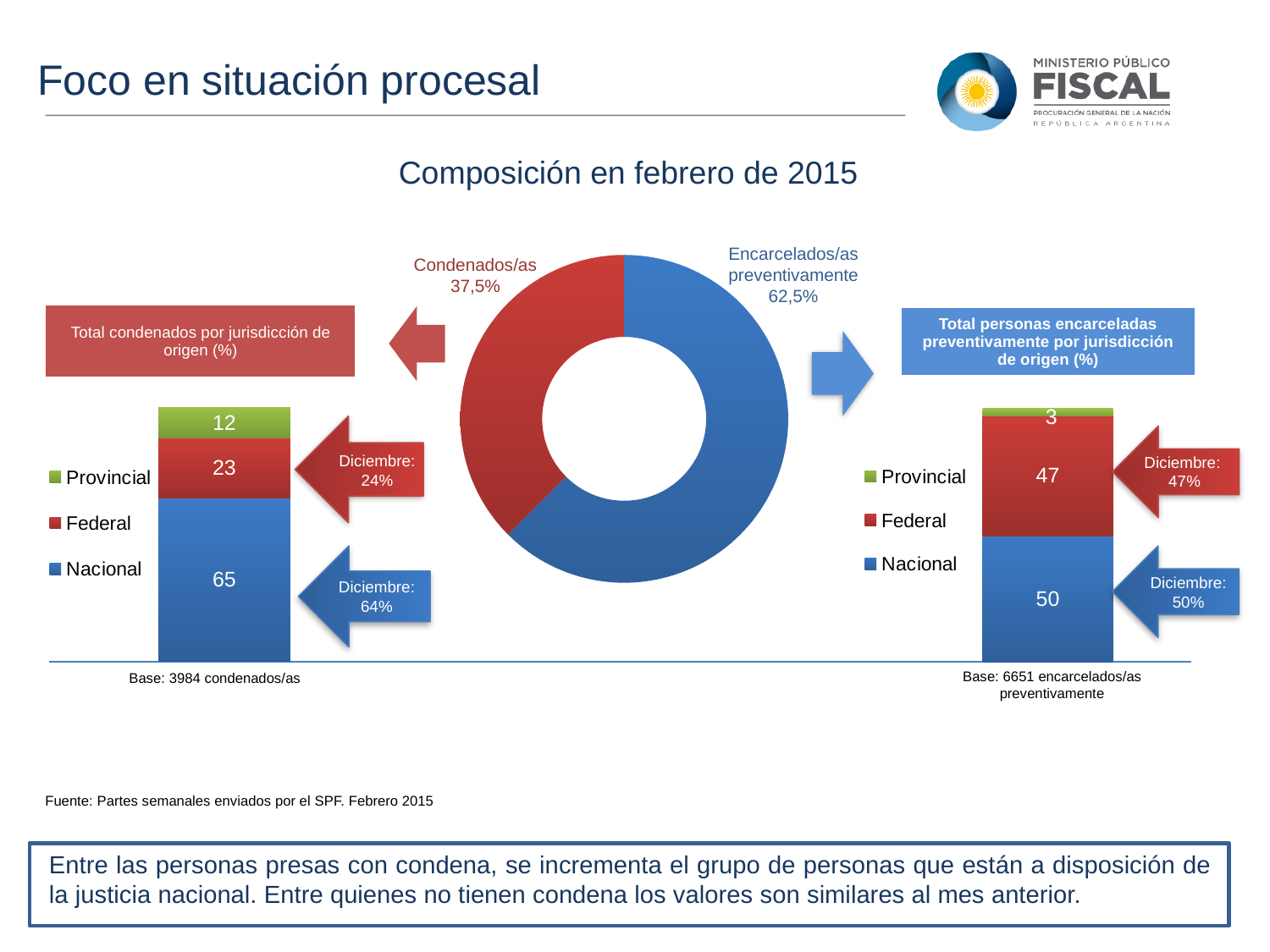
How many series does the legend of the left stacked bar chart (Total condenados por jurisdicción de origen) list? 3 In the left stacked bar chart (Total condenados por jurisdicción de origen), what is the value for Nacional? 65 In the right stacked bar chart (Total personas encarceladas preventivamente por jurisdicción de origen), what is the value for Federal? 47 In the right stacked bar chart (Total personas encarceladas preventivamente por jurisdicción de origen), which jurisdiction has the highest value? Nacional In the central donut chart, what share is labelled for Condenados/as? 37,5% In the left stacked bar chart (Total condenados por jurisdicción de origen), which jurisdiction has the lowest value? Provincial What kind of chart is the central chart showing Condenados/as and Encarcelados/as preventivamente? Donut (pie) chart In the left stacked bar chart (Total condenados por jurisdicción de origen), what is the value for Provincial? 12 Is the Federal value larger in the left stacked bar chart (Total condenados) or in the right stacked bar chart (Total personas encarceladas preventivamente)? Right chart (Total personas encarceladas preventivamente) In the central donut chart, what share is labelled for Encarcelados/as preventivamente? 62,5% In the left stacked bar chart (Total condenados por jurisdicción de origen), what is the difference between Nacional and Federal? 42 In the right stacked bar chart (Total personas encarceladas preventivamente por jurisdicción de origen), what is the difference between Nacional and Provincial? 47